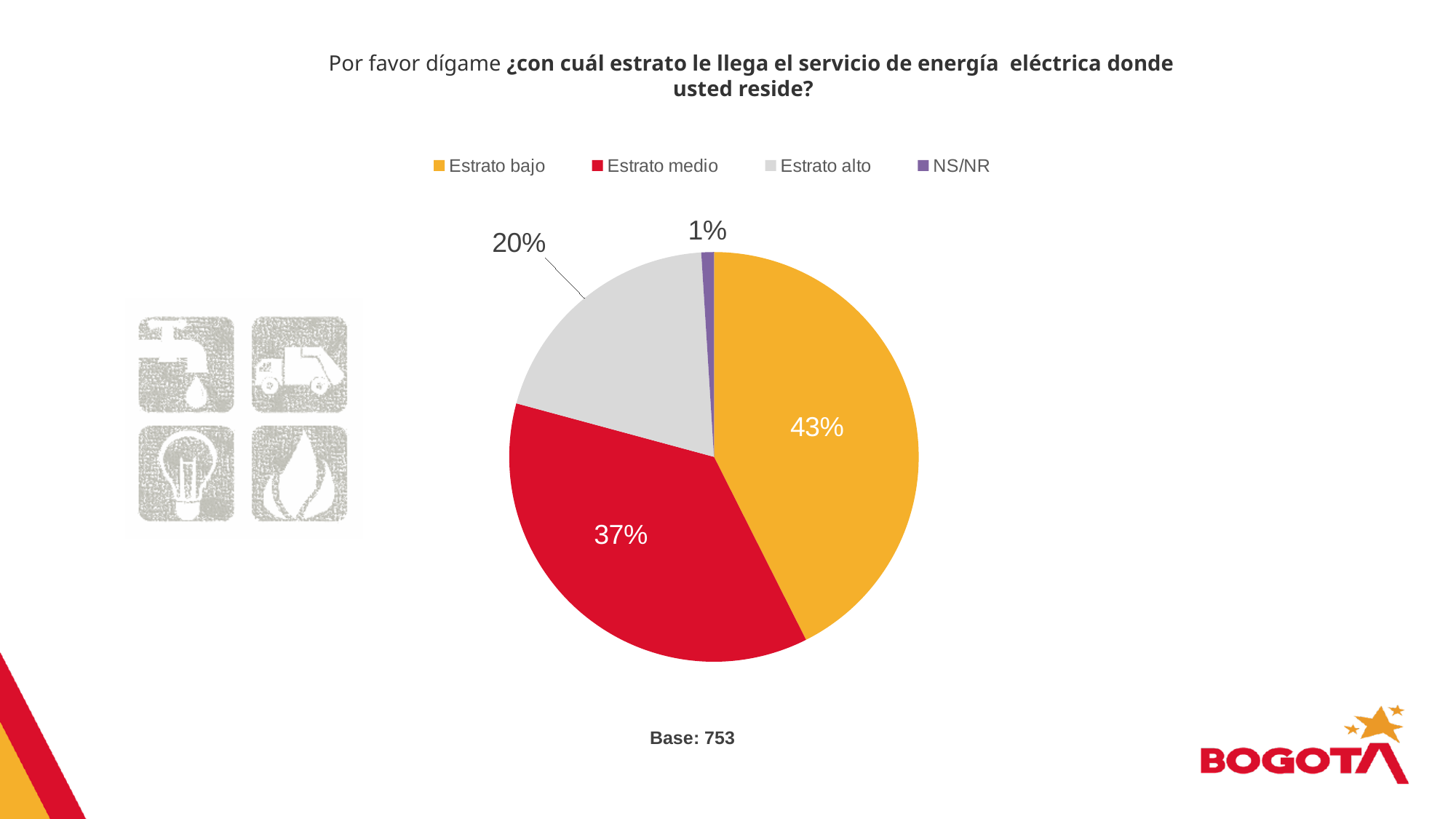
What kind of chart is shown on the slide? pie chart What base (sample size) is stated below the chart? 753 Which category has the smallest slice of the pie? NS/NR What share of the pie does Estrato bajo have? 43% What colour is the slice for Estrato alto? grey Which is larger, the slice for Estrato medio or the slice for Estrato alto? Estrato medio What share of the pie does Estrato alto have? 20% Which category has the largest slice of the pie? Estrato bajo What share of the pie does NS/NR have? 1% What is the difference in percentage points between Estrato bajo and Estrato medio? 6 How many categories does the legend list? 4